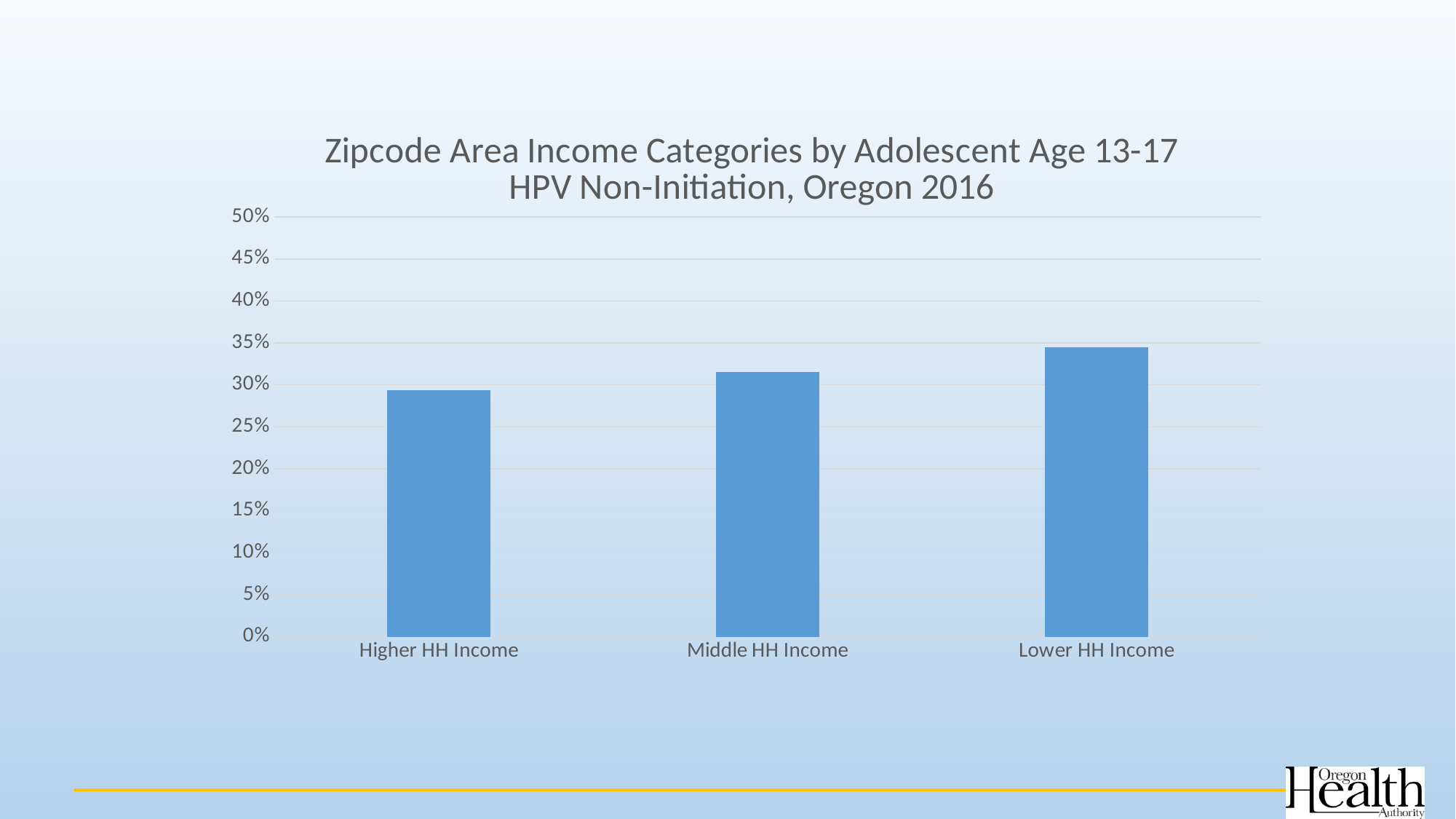
Is the value for Lower HH Income greater or less than 30%? greater What kind of chart is shown on the slide? bar chart What is the title of the chart? Zipcode Area Income Categories by Adolescent Age 13-17 HPV Non-Initiation, Oregon 2016 How many income categories are plotted on the chart? 3 Is the value for Lower HH Income greater or less than 35%? less Do the values rise or fall moving from Higher HH Income to Lower HH Income along the x axis? rise Which income category has the highest HPV non-initiation value? Lower HH Income Is the value for Higher HH Income greater or less than 30%? less What is the maximum value shown on the y axis? 50% Which is larger, the value for Middle HH Income or the value for Higher HH Income? Middle HH Income Which income category has the lowest HPV non-initiation value? Higher HH Income